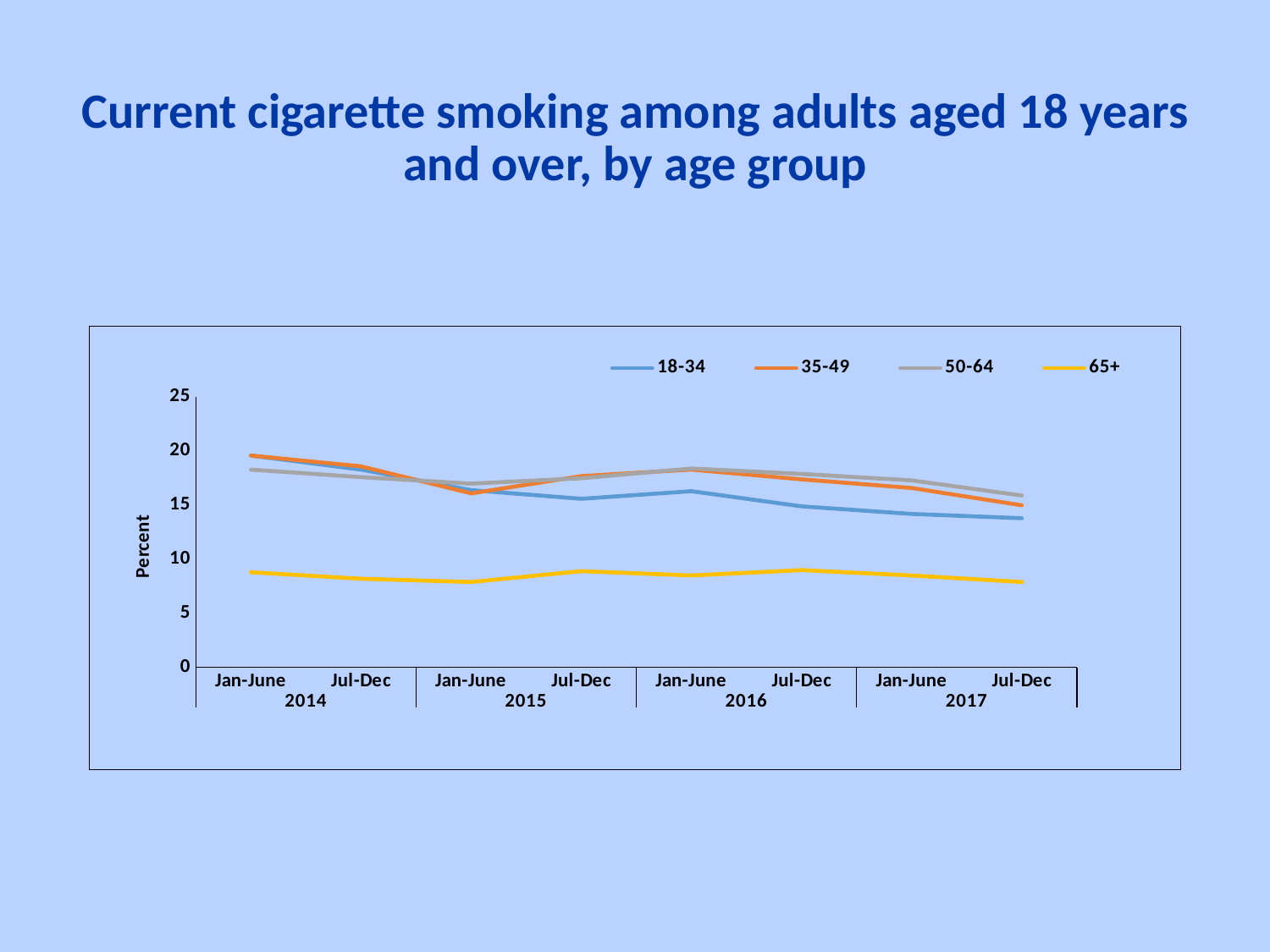
How many time points are plotted along the x axis? 8 Which age group has the highest value in Jul-Dec 2017? 50-64 How many series does the legend list? 4 Which age group has the lowest smoking percentage across the whole period? 65+ Which is larger in Jul-Dec 2017, the value for 18-34 or the value for 65+? 18-34 What is the title of the slide? Current cigarette smoking among adults aged 18 years and over, by age group Is the value for the 18-34 group in Jul-Dec 2017 greater or less than 15? less Is the value for the 35-49 group in Jan-June 2014 greater or less than 15? greater Does the 18-34 line generally rise or fall from Jan-June 2014 to Jul-Dec 2017? fall What kind of chart is shown on the slide? line chart Is the value for the 65+ group in Jan-June 2014 greater or less than 10? less What is the label on the y axis? Percent